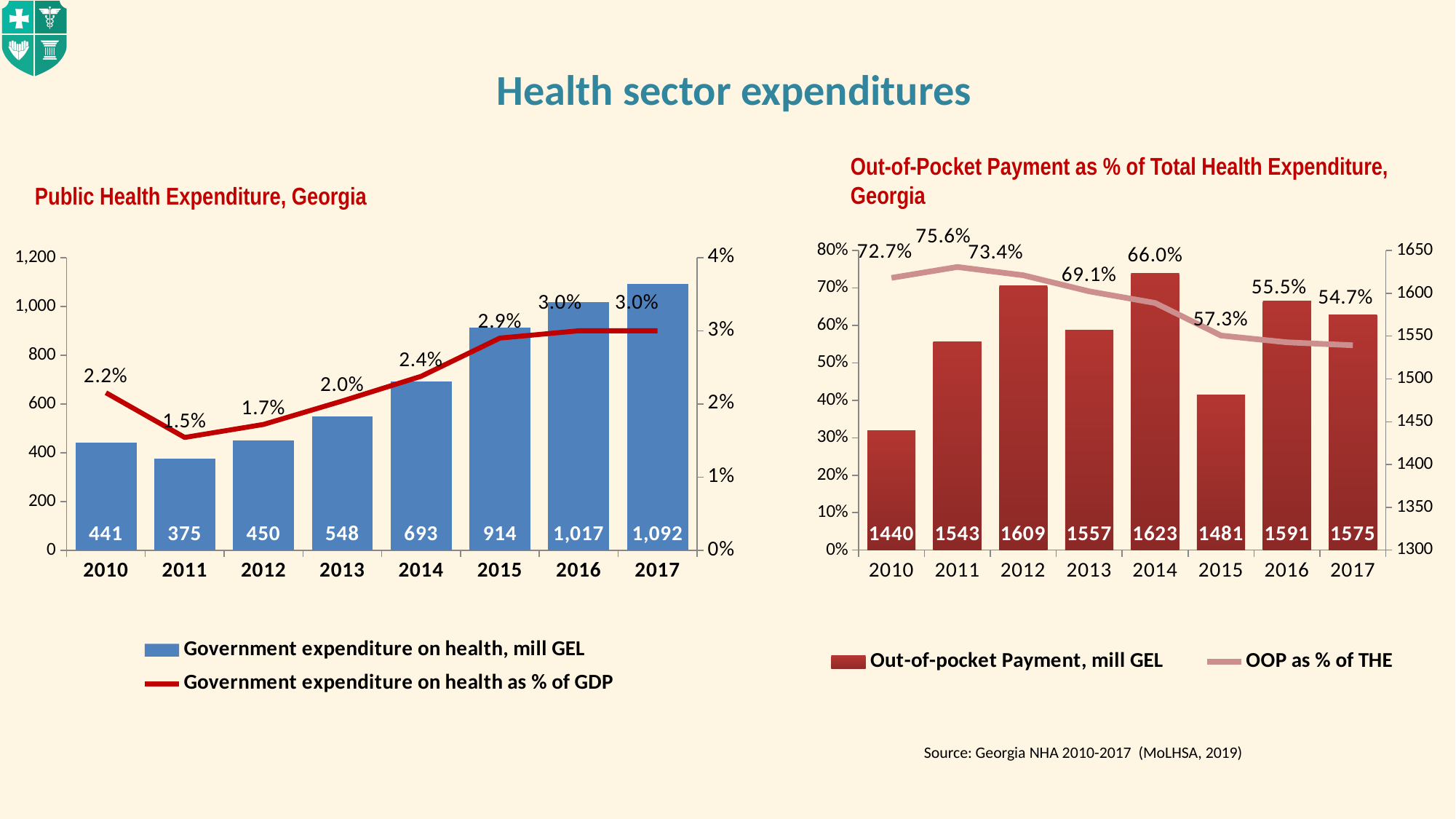
In the 'Out-of-Pocket Payment as % of Total Health Expenditure, Georgia' chart, what was out-of-pocket payment in mill GEL in 2012? 1609 In the 'Out-of-Pocket Payment as % of Total Health Expenditure, Georgia' chart, which year has the highest out-of-pocket payment in mill GEL? 2014 How many years are shown on the x axis of the 'Out-of-Pocket Payment as % of Total Health Expenditure, Georgia' chart? 8 In the 'Out-of-Pocket Payment as % of Total Health Expenditure, Georgia' chart, is out-of-pocket payment in mill GEL larger in 2013 or 2016? 2016 In the 'Public Health Expenditure, Georgia' chart, what was government expenditure on health in mill GEL in 2014? 693 In the 'Public Health Expenditure, Georgia' chart, which year has the lowest government expenditure on health in mill GEL? 2011 In the 'Out-of-Pocket Payment as % of Total Health Expenditure, Georgia' chart, which year has the highest OOP as % of THE? 2011 In the 'Public Health Expenditure, Georgia' chart, what was government expenditure on health as % of GDP in 2011? 1.5% In the 'Public Health Expenditure, Georgia' chart, by how much did government expenditure on health in mill GEL increase from 2016 to 2017? 75 In the 'Public Health Expenditure, Georgia' chart, does government expenditure on health in mill GEL generally rise or fall from 2011 to 2017? rise In the 'Public Health Expenditure, Georgia' chart, how many series does the legend list? 2 In the 'Out-of-Pocket Payment as % of Total Health Expenditure, Georgia' chart, what was OOP as % of THE in 2017? 54.7%